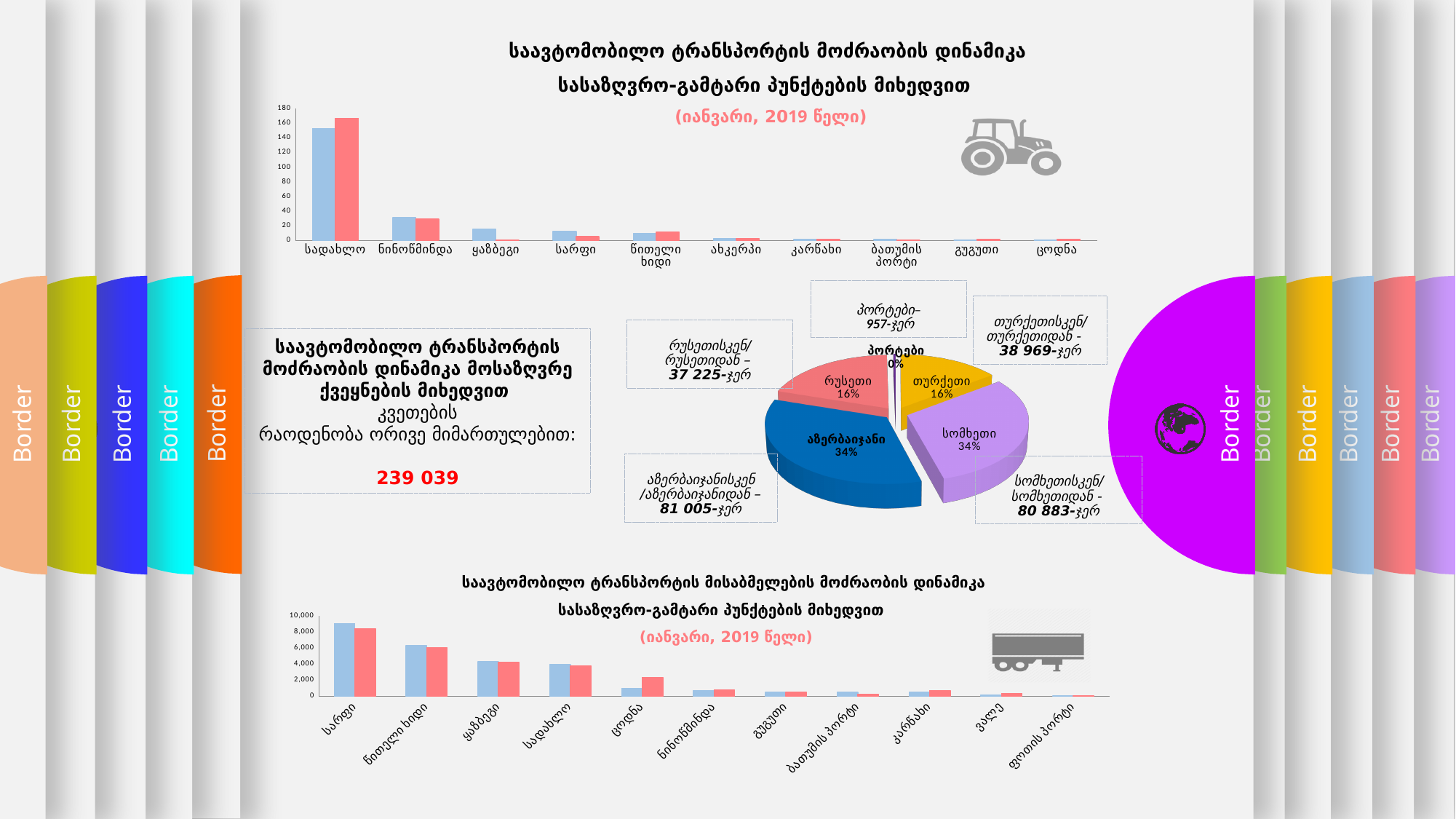
In the top bar chart, how many categories are shown on the x axis? 10 In the pie chart, what value is given in the callout for აზერბაიჯანისკენ/აზერბაიჯანიდან? 81 005-ჯერ In the pie chart, which is larger, the share for სომხეთი or the share for თურქეთი? სომხეთი In the pie chart, what value is given in the callout for პორტები? 957-ჯერ In the pie chart, what share does რუსეთი have? 16% In the pie chart, what is the difference between the share for აზერბაიჯანი and the share for რუსეთი? 18% In the pie chart, what share does სომხეთი have? 34% In the top bar chart, which category has the highest value? სადახლო In the pie chart, which slice is the smallest? პორტები In the bottom bar chart, is the value of the blue bar for სარფი greater or less than 8,000? greater In the bottom bar chart, how many categories are shown on the x axis? 11 In the top bar chart, is the value of the blue bar for სადახლო greater or less than 140? greater